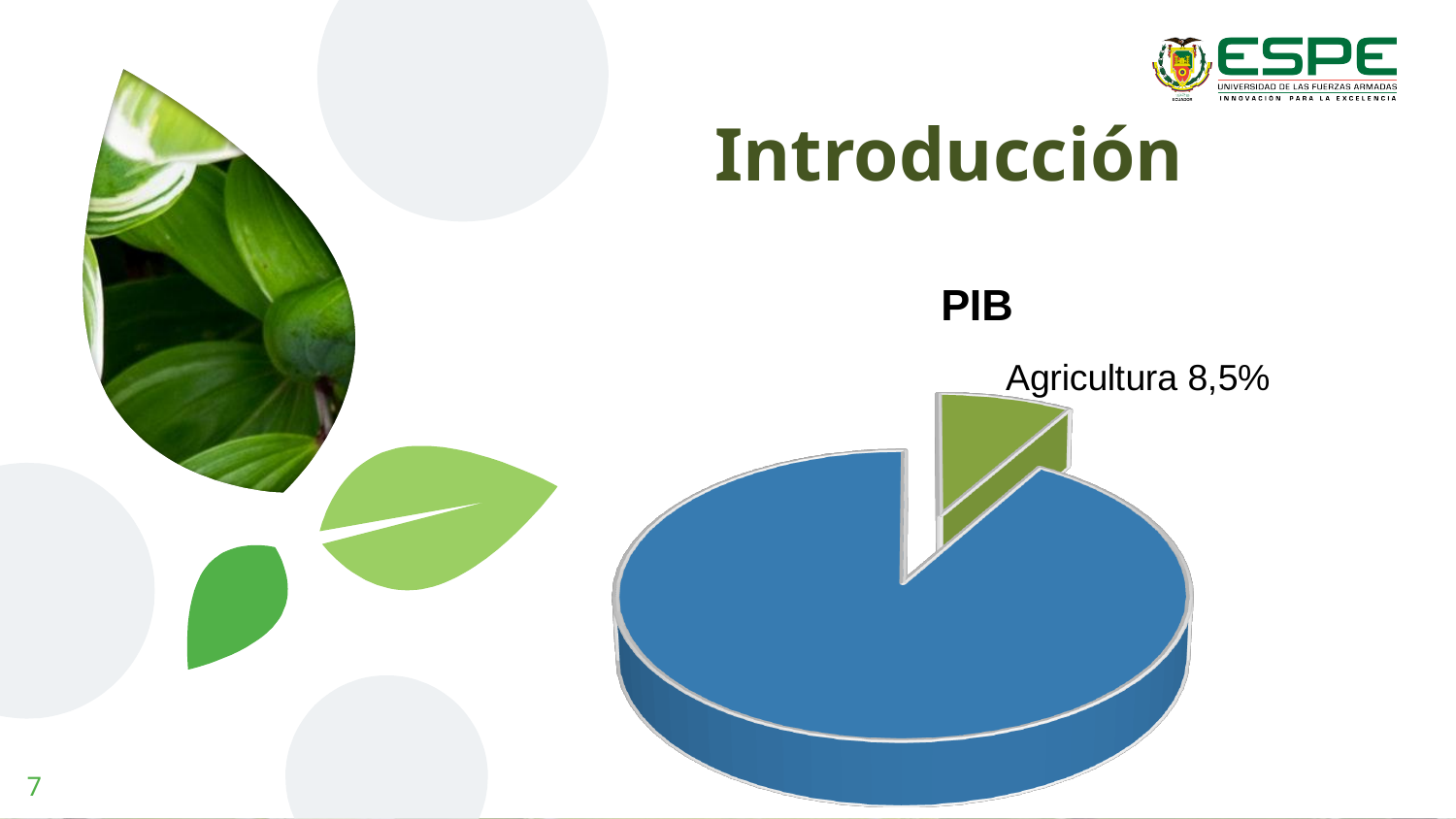
Which is larger, the Agricultura slice or the blue slice? The blue slice How many slices does the pie chart have? 2 What share of the pie does Agricultura represent? 8,5% What is the title of the chart? PIB What kind of chart is shown on the slide? Pie chart Which slice of the pie is labelled? Agricultura Is the Agricultura slice the largest or the smallest slice of the pie? Smallest What colour is the Agricultura slice? Green